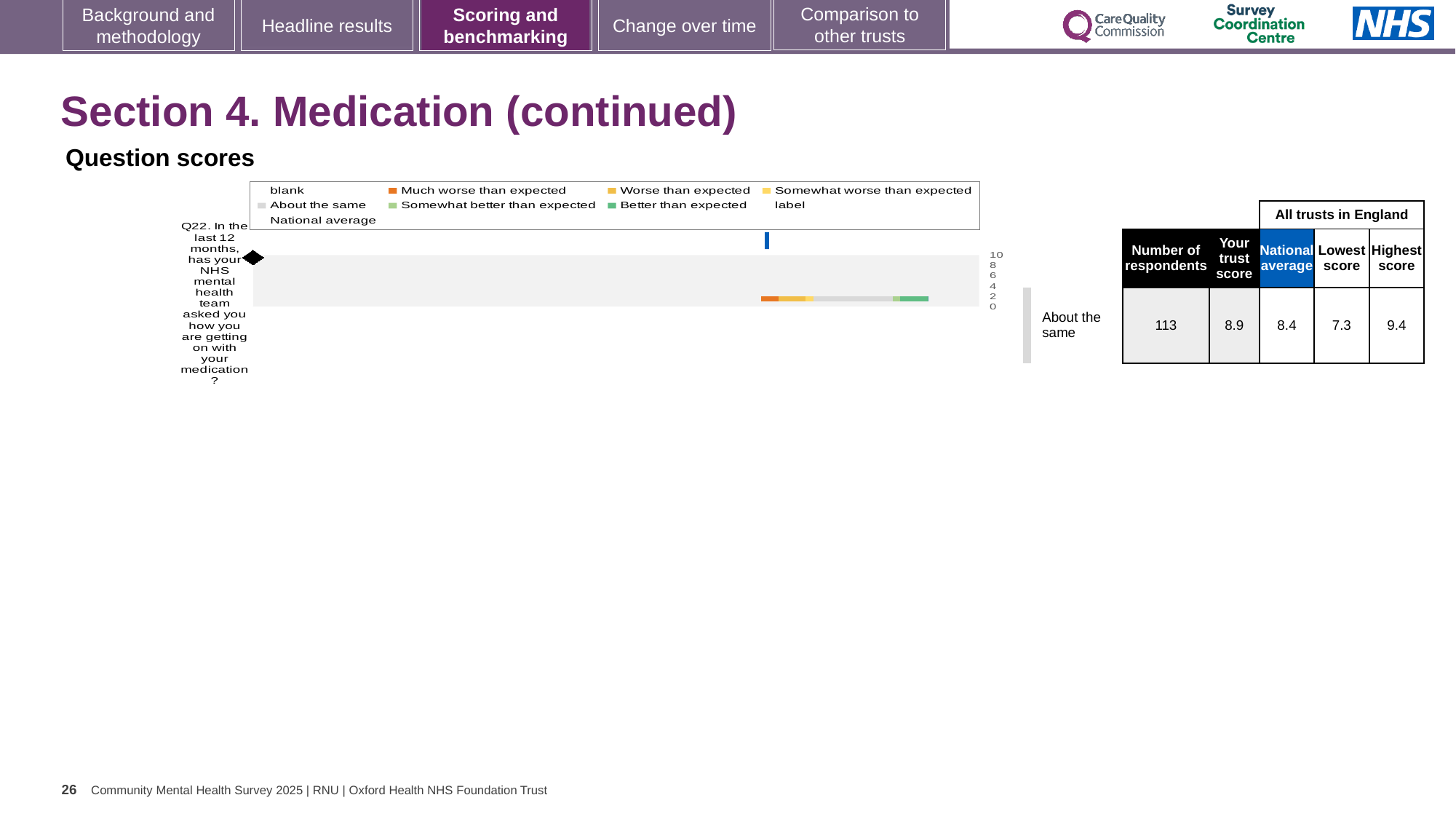
In the table beside the chart, what is the number of respondents for Q22? 113 In the table beside the chart, what is the lowest score among all trusts in England for Q22? 7.3 In the table beside the chart, what is the national average for Q22? 8.4 What is the highest value shown on the chart's numeric axis? 10 In the table beside the chart, what is the difference between the trust score and the national average for Q22? 0.5 Which question number is plotted on the chart? Q22 In the table beside the chart, which is larger for Q22: the trust score or the national average? trust score In the table beside the chart, what is the highest score among all trusts in England for Q22? 9.4 How many questions (categories) are plotted on the chart? 1 In the table beside the chart, what is the trust's score for Q22? 8.9 Which legend entry is shown in orange on the chart? Much worse than expected What kind of chart is shown on the slide? bar chart